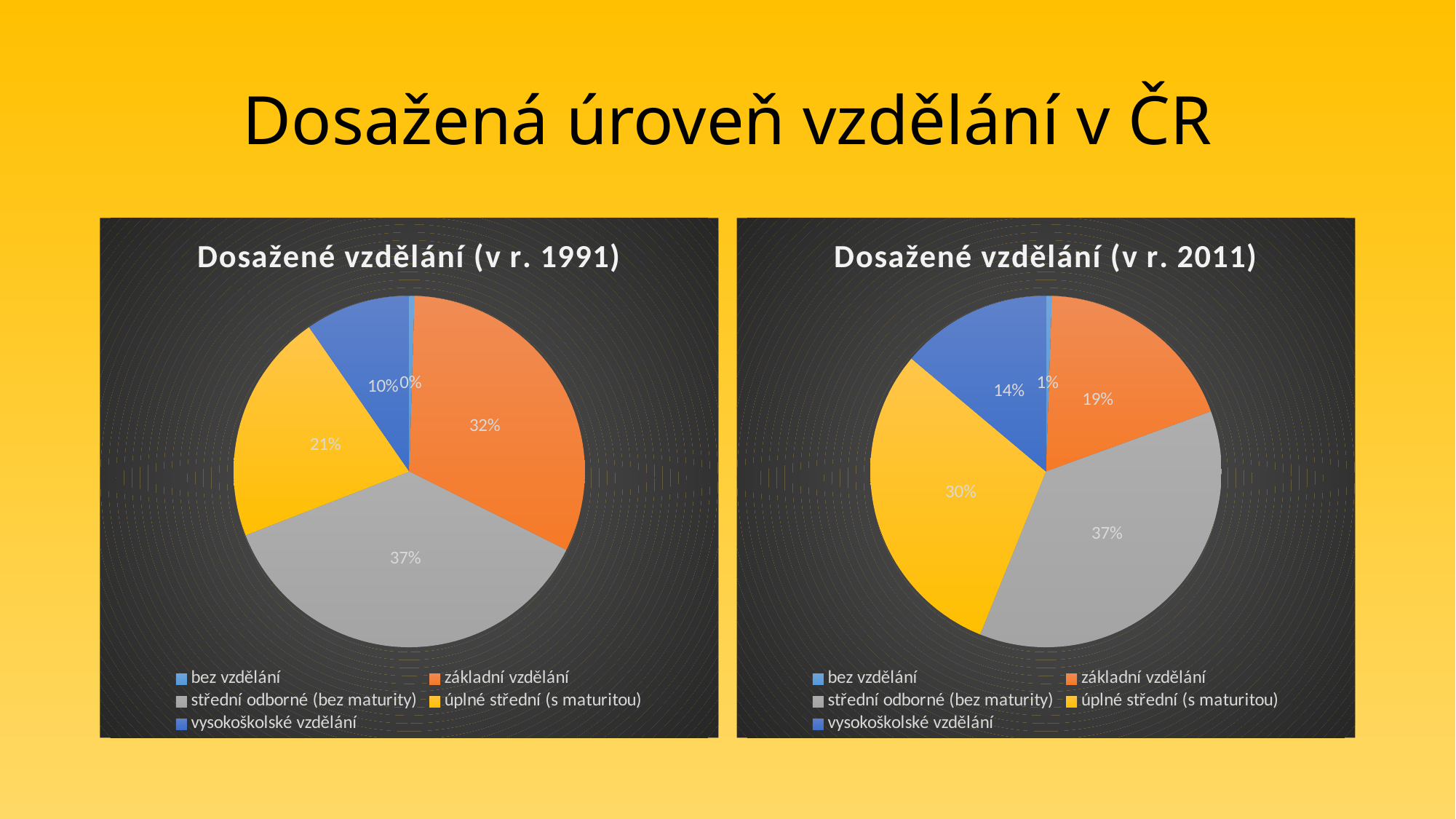
In the chart titled "Dosažené vzdělání (v r. 1991)", which is larger: "úplné střední (s maturitou)" or "vysokoškolské vzdělání"? úplné střední (s maturitou) What type of chart is the chart titled "Dosažené vzdělání (v r. 2011)"? pie chart How many categories does the chart titled "Dosažené vzdělání (v r. 1991)" show in its legend? 5 In the chart titled "Dosažené vzdělání (v r. 2011)", what share does "úplné střední (s maturitou)" have? 30% In the chart titled "Dosažené vzdělání (v r. 1991)", what share does "základní vzdělání" have? 32% In the chart titled "Dosažené vzdělání (v r. 2011)", what is the difference between the shares of "střední odborné (bez maturity)" and "základní vzdělání"? 18% In the chart titled "Dosažené vzdělání (v r. 1991)", which category has the largest slice? střední odborné (bez maturity) What colour is the "střední odborné (bez maturity)" slice in the chart titled "Dosažené vzdělání (v r. 2011)"? grey In the chart titled "Dosažené vzdělání (v r. 1991)", what share does "bez vzdělání" have? 0% In the chart titled "Dosažené vzdělání (v r. 2011)", what share does "vysokoškolské vzdělání" have? 14% In the chart titled "Dosažené vzdělání (v r. 2011)", which category has the smallest slice? bez vzdělání In the chart titled "Dosažené vzdělání (v r. 1991)", what share does "vysokoškolské vzdělání" have? 10%